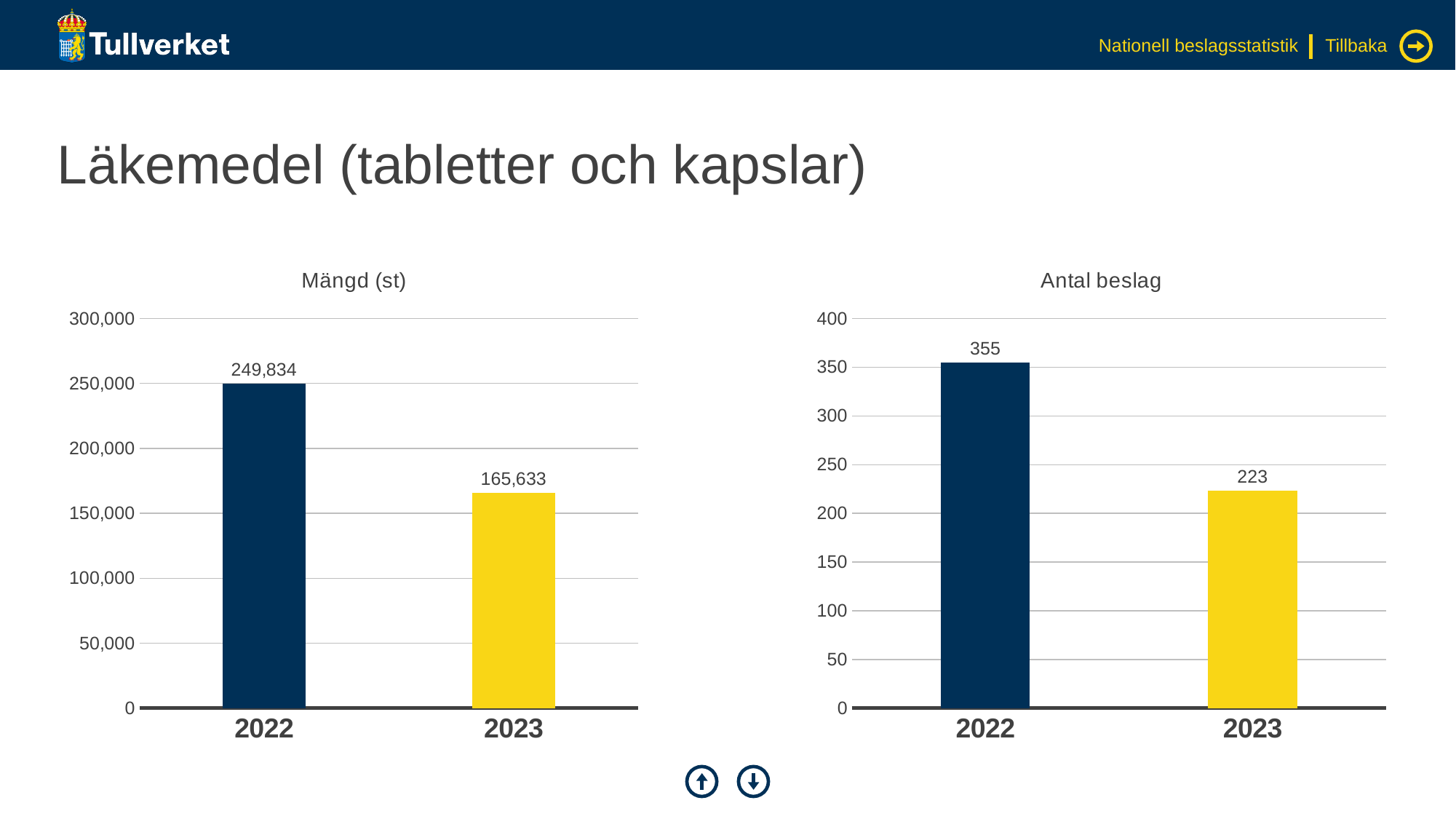
In the 'Antal beslag' chart, what is the value for 2022? 355 In the 'Mängd (st)' chart, do the values rise or fall from 2022 to 2023? Fall In the 'Antal beslag' chart, which year has the lowest value? 2023 What kind of chart is the 'Antal beslag' chart? Bar chart How many bars are in the 'Mängd (st)' chart? 2 In the 'Mängd (st)' chart, which year has the highest value? 2022 In the 'Mängd (st)' chart, what is the difference between the 2022 and 2023 values? 84,201 In the 'Antal beslag' chart, what is the value for 2023? 223 In the 'Antal beslag' chart, what is the difference between the 2022 and 2023 values? 132 In the 'Antal beslag' chart, is the value for 2022 greater or less than 300? greater In the 'Mängd (st)' chart, what is the value for 2023? 165,633 In the 'Mängd (st)' chart, what is the value for 2022? 249,834